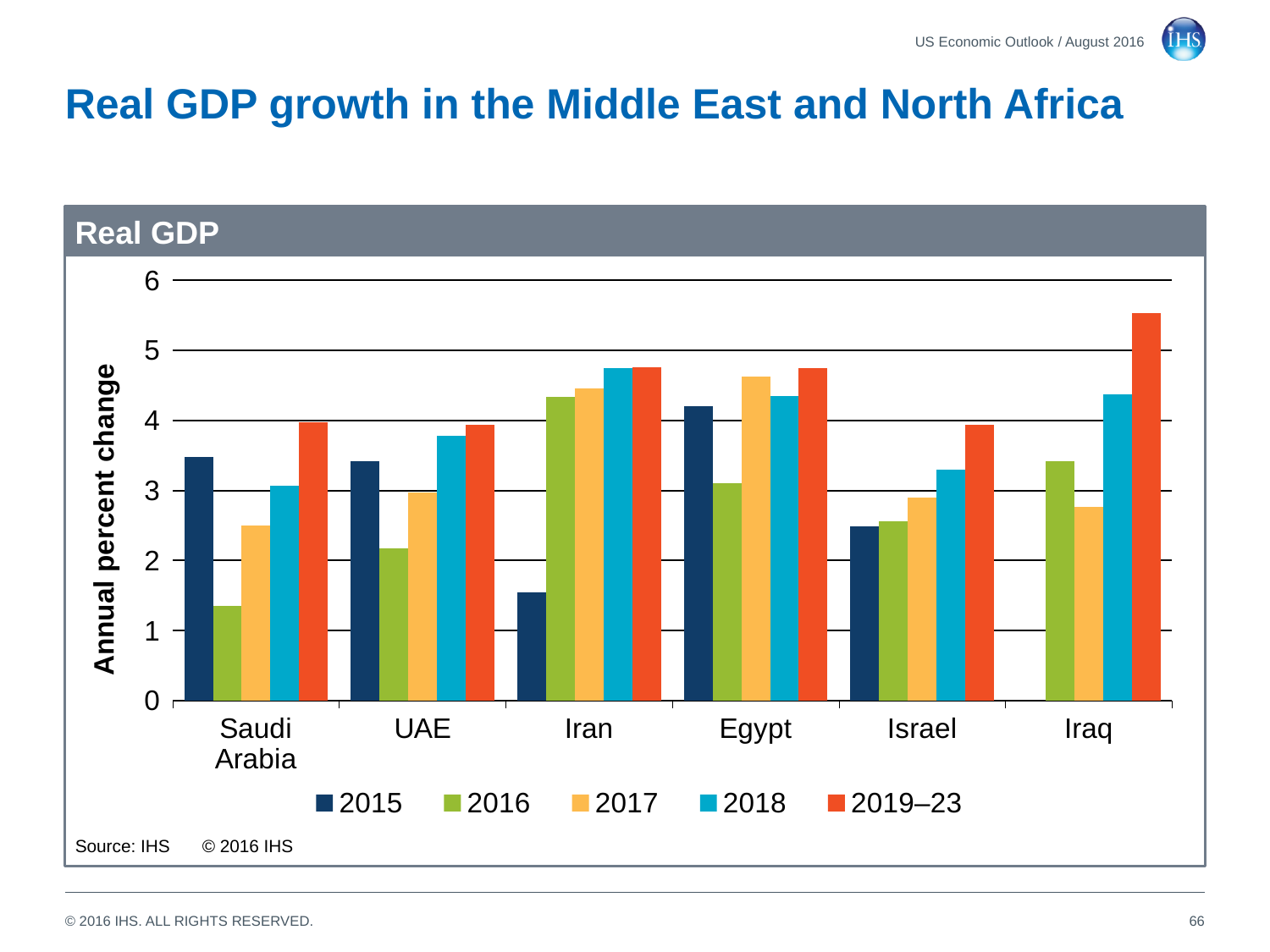
How many countries are shown on the x axis? 6 Which is larger, the 2015 value for Iran or the 2015 value for Egypt? Egypt How many series does the legend list? 5 Is the 2019–23 value for Iraq greater or less than 5? greater Which country has the highest value for 2019–23? Iraq Is the 2015 value for Iran greater or less than 2? less Is the 2016 value for Saudi Arabia greater or less than 2? less Which country has the lowest value for 2016? Saudi Arabia What is the label on the vertical axis? Annual percent change Which country has the highest value for 2015? Egypt For Israel, do the values rise or fall from 2015 through 2019–23? rise What kind of chart is shown on the slide? Bar chart